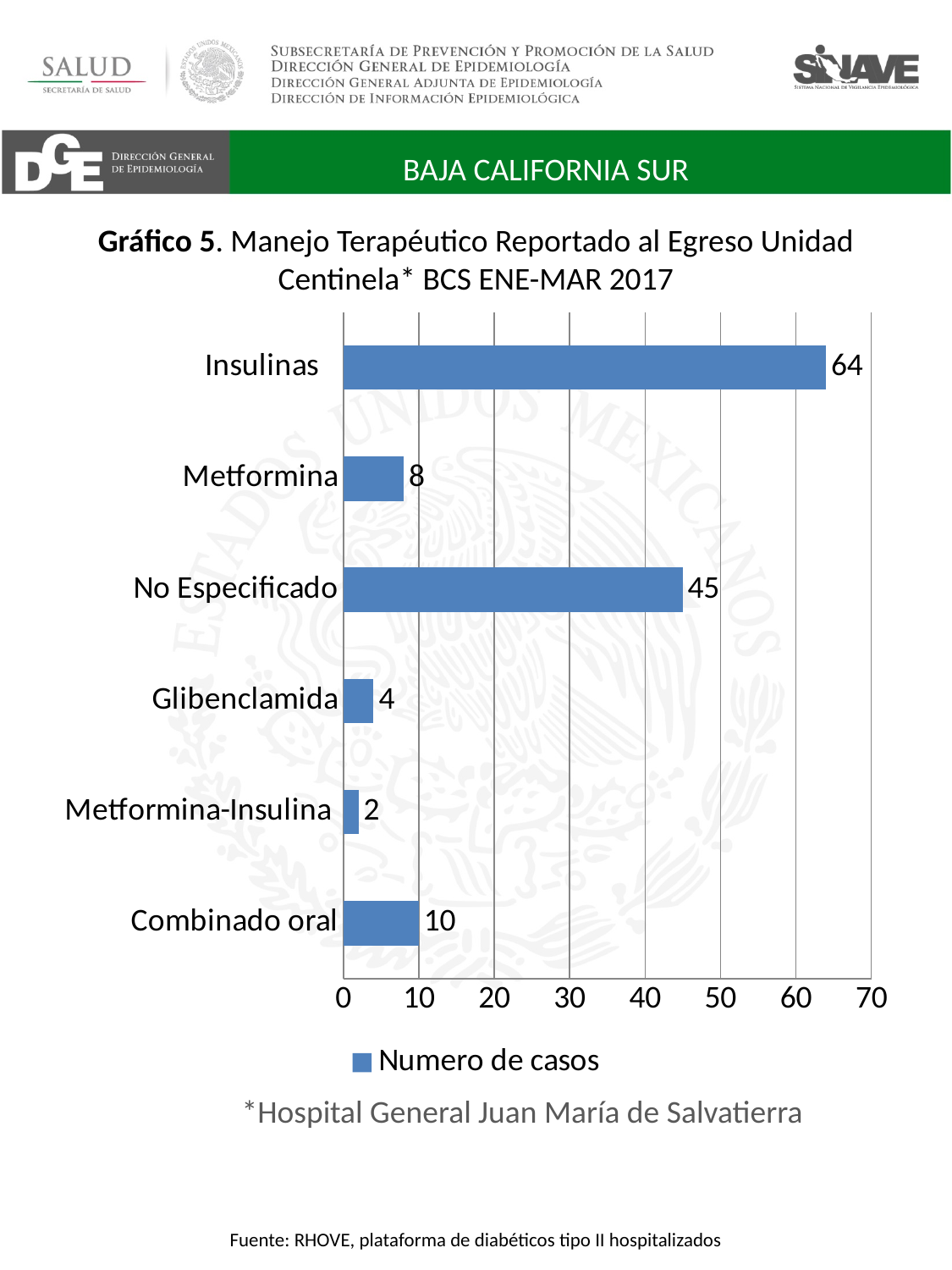
How many categories are shown in the chart? 6 What is the number of cases for No Especificado? 45 What kind of chart is shown on the slide? Bar chart What is the legend entry of the chart? Numero de casos What is the number of cases for Combinado oral? 10 Which has more cases, Metformina or Glibenclamida? Metformina What is the number of cases for Insulinas? 64 How many series does the legend list? 1 Which category has the lowest number of cases? Metformina-Insulina What is the number of cases for Metformina-Insulina? 2 What is the difference in number of cases between Insulinas and No Especificado? 19 Which category has the highest number of cases? Insulinas